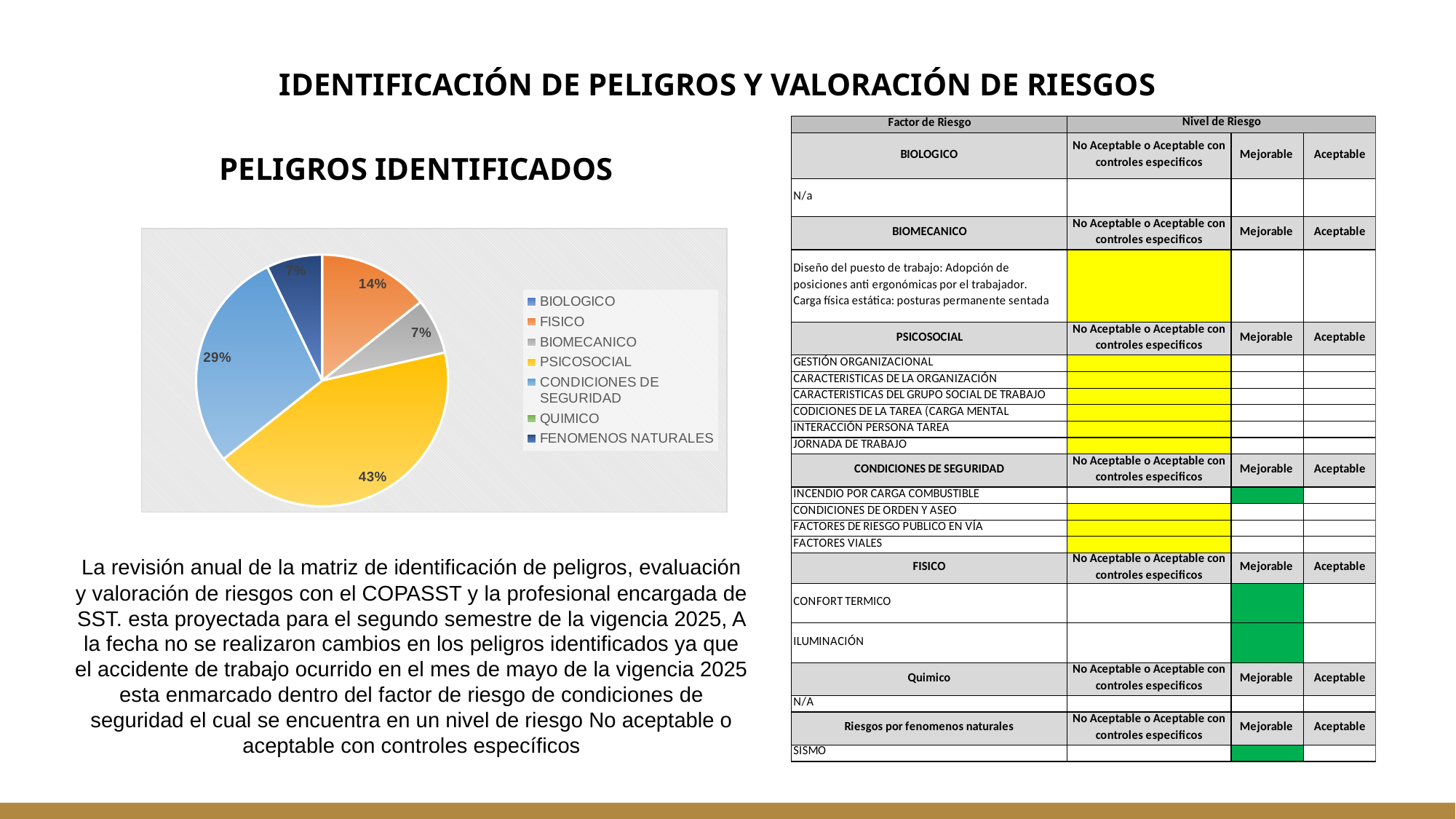
Which category has the largest slice in the pie chart? PSICOSOCIAL What type of chart is shown under the heading PELIGROS IDENTIFICADOS? pie chart What is the difference in percentage points between the PSICOSOCIAL slice and the CONDICIONES DE SEGURIDAD slice? 14 percentage points What percentage of the pie chart does BIOMECANICO represent? 7% Which slice is larger in the pie chart, FISICO or BIOMECANICO? FISICO What is the title shown above the pie chart? PELIGROS IDENTIFICADOS What percentage of the pie chart does FENOMENOS NATURALES represent? 7% What percentage of the pie chart does PSICOSOCIAL represent? 43% How many entries does the legend of the pie chart list? 7 What percentage of the pie chart does FISICO represent? 14% What percentage of the pie chart does CONDICIONES DE SEGURIDAD represent? 29% What is the combined share of the PSICOSOCIAL and CONDICIONES DE SEGURIDAD slices? 72%